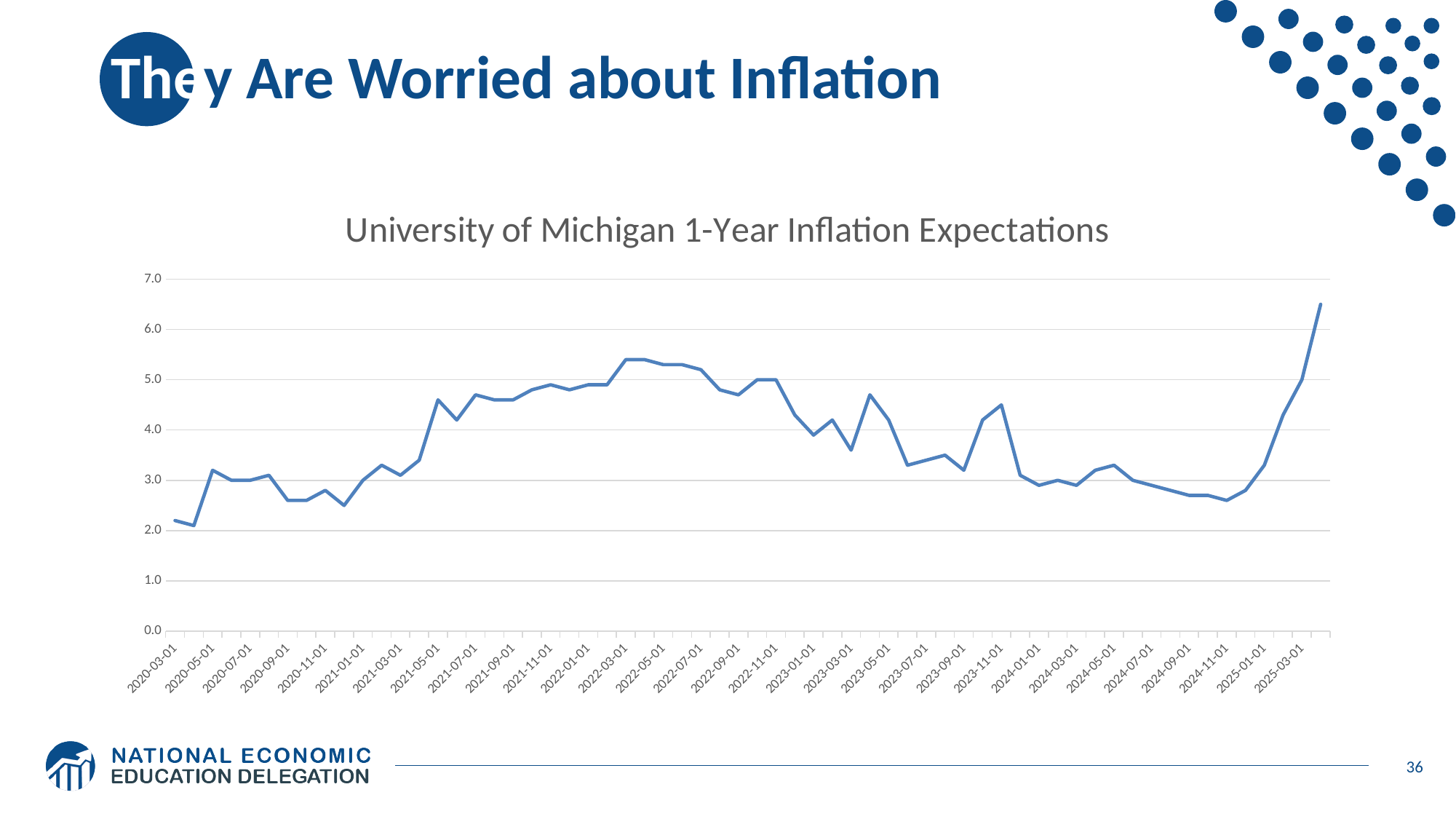
Is the value for 2024-11-01 greater or less than 3.0? less Is the value for 2025-03-01 greater or less than 4.0? greater Which is larger, the value for 2020-03-01 or the value for 2021-05-01? 2021-05-01 Is the final point on the line greater or less than 6.0? greater Does the line reach its highest value at the beginning or at the end of the period shown? At the end Which is larger, the value for 2022-03-01 or the value for 2024-01-01? 2022-03-01 How many lines are plotted on the chart? 1 What is the title of the chart? University of Michigan 1-Year Inflation Expectations Does the line rise or fall from 2024-11-01 to the end of the series? Rise What type of chart is shown on the slide? Line chart